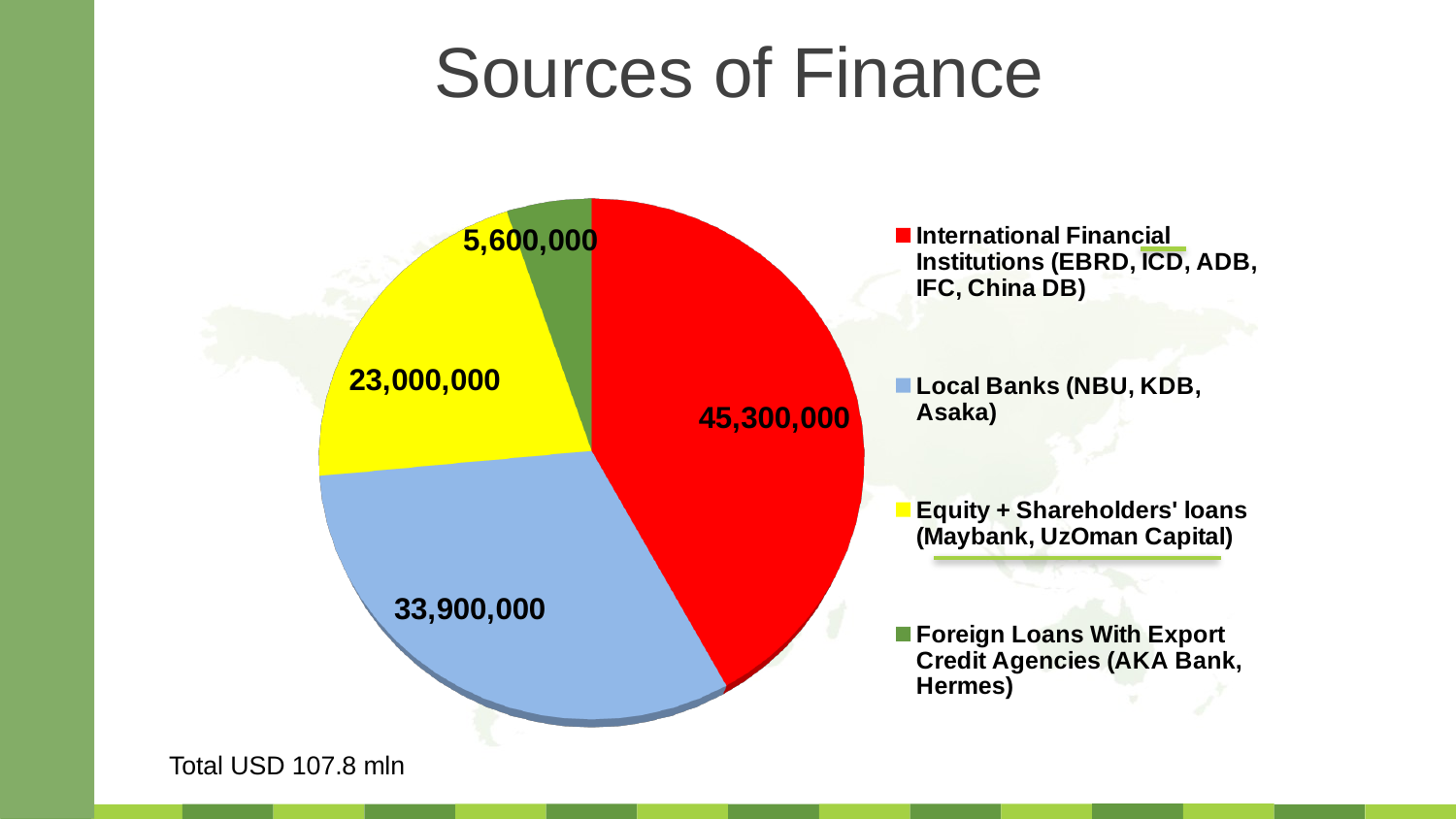
What colour is the slice for Equity + Shareholders' loans (Maybank, UzOman Capital)? Yellow What kind of chart is shown on the slide? Pie chart Which source of finance has the smallest slice? Foreign Loans With Export Credit Agencies (AKA Bank, Hermes) Which source of finance has the largest slice? International Financial Institutions (EBRD, ICD, ADB, IFC, China DB) What is the value for Foreign Loans With Export Credit Agencies (AKA Bank, Hermes)? 5,600,000 How many slices does the pie chart have? 4 What is the difference between the International Financial Institutions value and the Local Banks value? 11,400,000 What is the value for International Financial Institutions (EBRD, ICD, ADB, IFC, China DB)? 45,300,000 What is the value for Local Banks (NBU, KDB, Asaka)? 33,900,000 What is the value for Equity + Shareholders' loans (Maybank, UzOman Capital)? 23,000,000 Which is larger, Local Banks or Equity + Shareholders' loans? Local Banks What is the difference between the Equity + Shareholders' loans value and the Foreign Loans With Export Credit Agencies value? 17,400,000